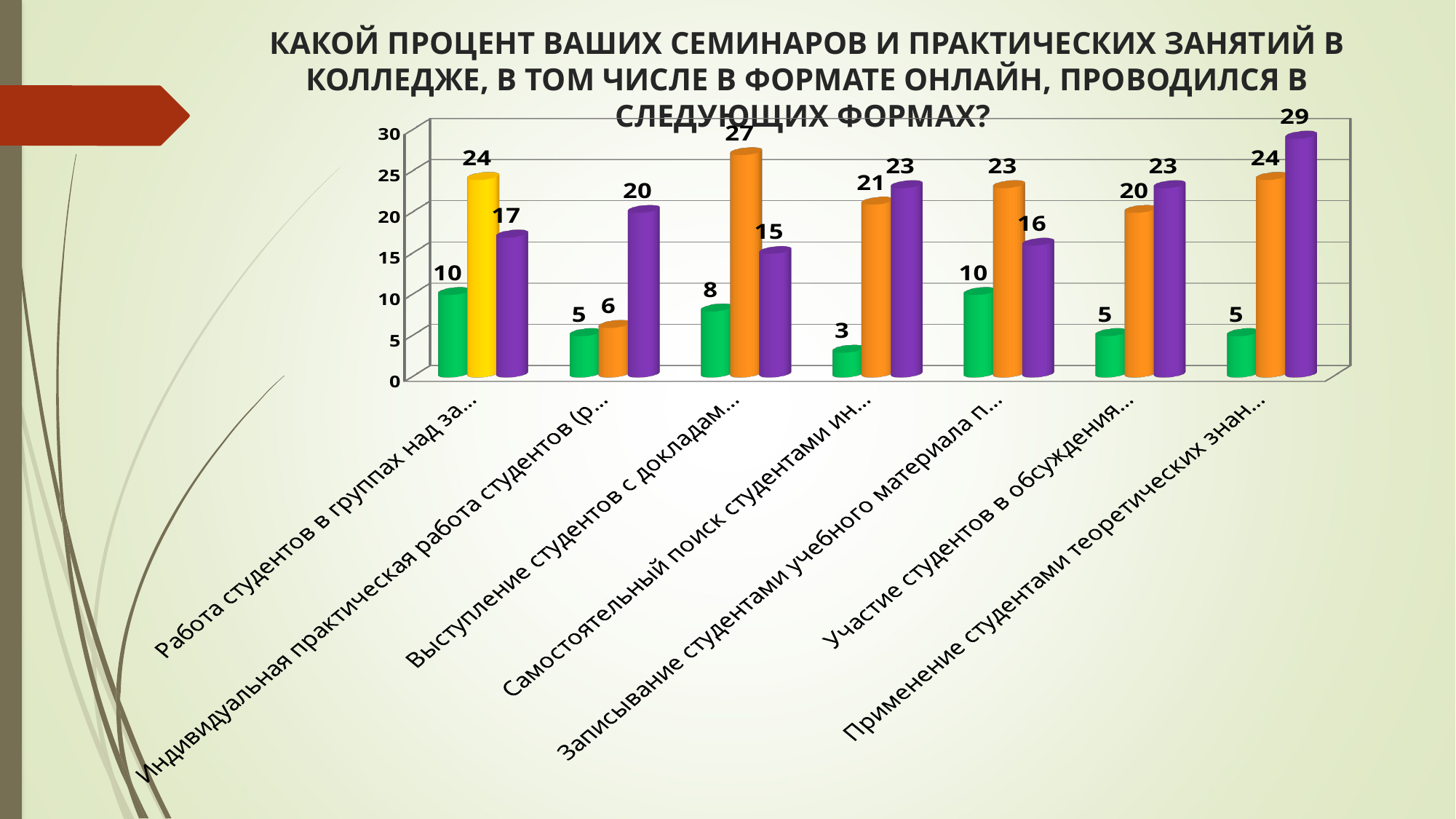
What is the value of the green bar for the category "Самостоятельный поиск студентами ин..."? 3 What is the value of the purple bar for the category "Применение студентами теоретических знан..."? 29 For the category "Индивидуальная практическая работа студентов (р...", which is larger: the orange bar or the purple bar? the purple bar What is the highest value shown on the vertical axis of the chart? 30 How many categories are shown along the x axis of the chart? 7 What is the value of the orange bar for the category "Выступление студентов с докладам..."? 27 What is the value of the green bar for the category "Работа студентов в группах над за..."? 10 Which category has the highest purple bar? Применение студентами теоретических знан... What is the value of the purple bar for the category "Записывание студентами учебного материала п..."? 16 What is the difference between the orange bar and the green bar for the category "Выступление студентов с докладам..."? 19 What kind of chart is shown on the slide? bar chart Which category has the lowest green bar? Самостоятельный поиск студентами ин...